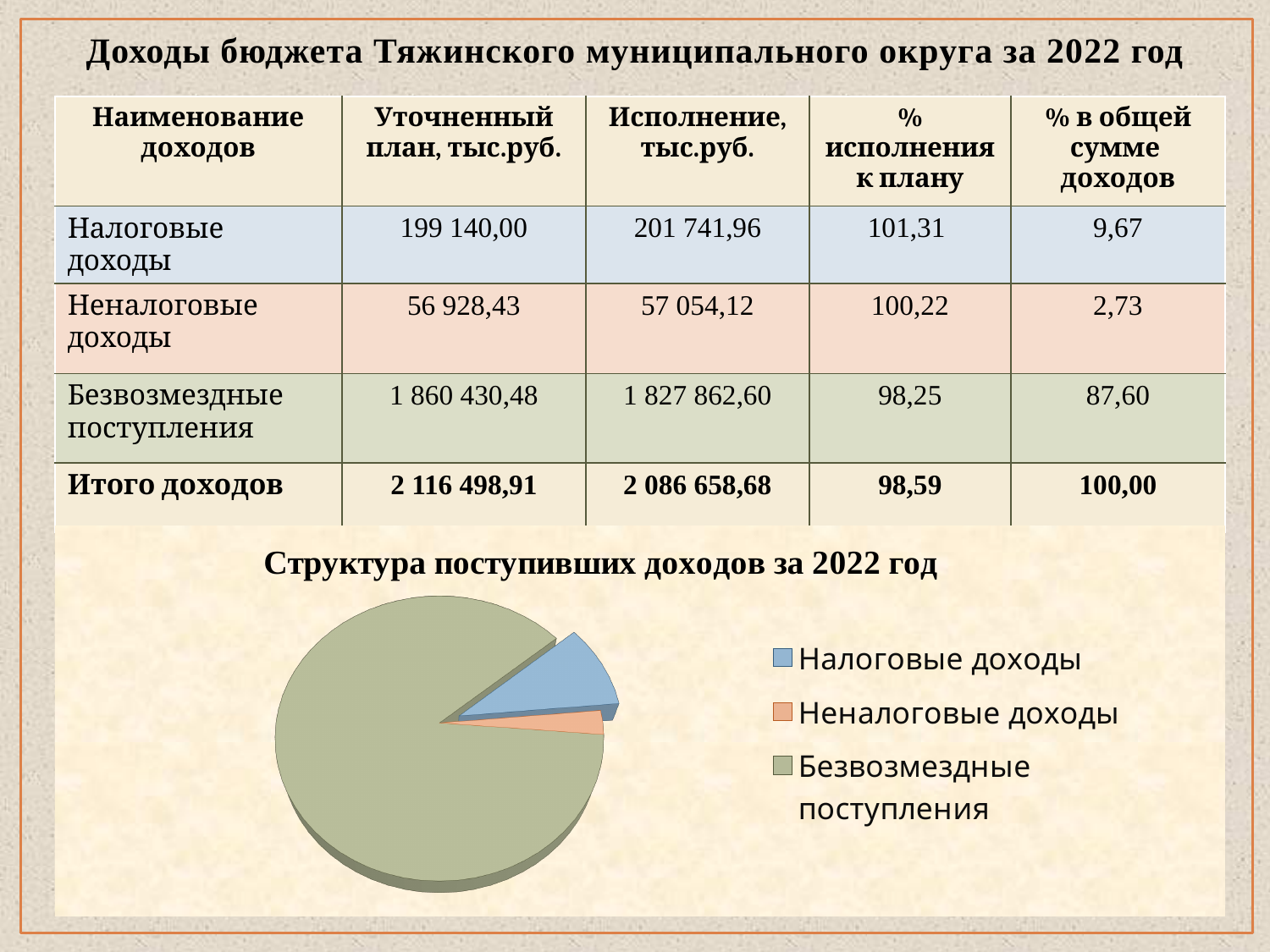
What is the title of the pie chart on the slide? Структура поступивших доходов за 2022 год In the pie chart, which slice is larger: Безвозмездные поступления or Налоговые доходы? Безвозмездные поступления Which category has the smallest slice in the pie chart 'Структура поступивших доходов за 2022 год'? Неналоговые доходы How many entries does the legend of the pie chart list? 3 What colour is the slice for Безвозмездные поступления in the pie chart? green According to the table on the slide, what share of total income (% в общей сумме доходов) does the Безвозмездные поступления slice of the pie chart represent? 87,60 According to the table on the slide, what share of total income (% в общей сумме доходов) does the Неналоговые доходы slice of the pie chart represent? 2,73 In the pie chart, which slice is larger: Налоговые доходы or Неналоговые доходы? Налоговые доходы Which category has the largest slice in the pie chart 'Структура поступивших доходов за 2022 год'? Безвозмездные поступления What kind of chart is shown under the heading 'Структура поступивших доходов за 2022 год'? pie chart How many slices does the pie chart 'Структура поступивших доходов за 2022 год' have? 3 According to the table on the slide, what share of total income (% в общей сумме доходов) does the Налоговые доходы slice of the pie chart represent? 9,67